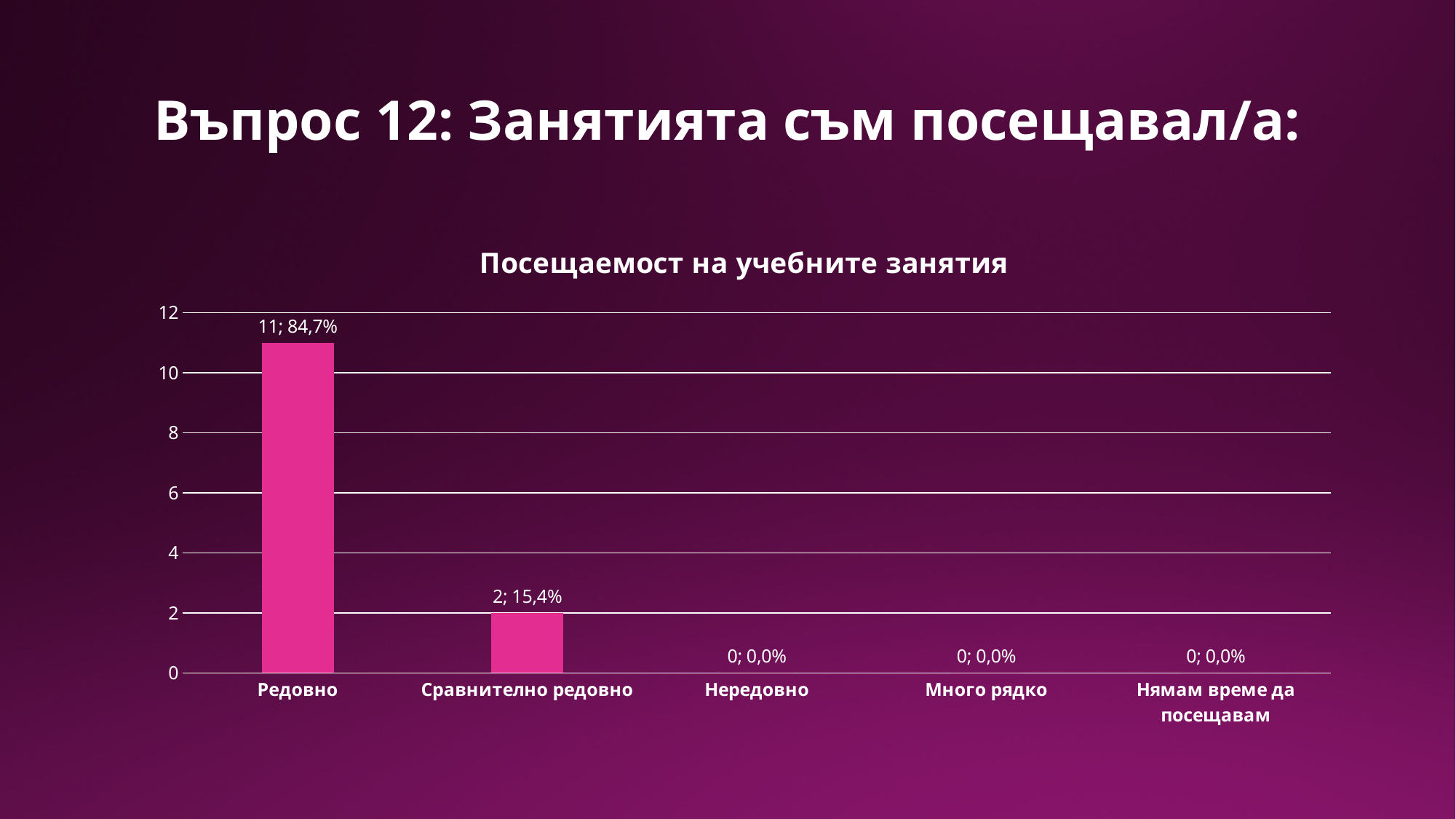
Do the values rise or fall from left to right along the x axis? fall What kind of chart is shown? bar chart What is the value for Нередовно? 0; 0,0% How many categories have a value of 0? 3 What is the value for Сравнително редовно? 2; 15,4% Which category has the highest value? Редовно What is the title of the chart? Посещаемост на учебните занятия What is the value for Редовно? 11; 84,7% Is the value for Редовно greater or less than 10? greater How many categories are shown on the x axis? 5 What is the difference in count between Редовно and Сравнително редовно? 9 Which is larger, the value for Редовно or the value for Сравнително редовно? Редовно